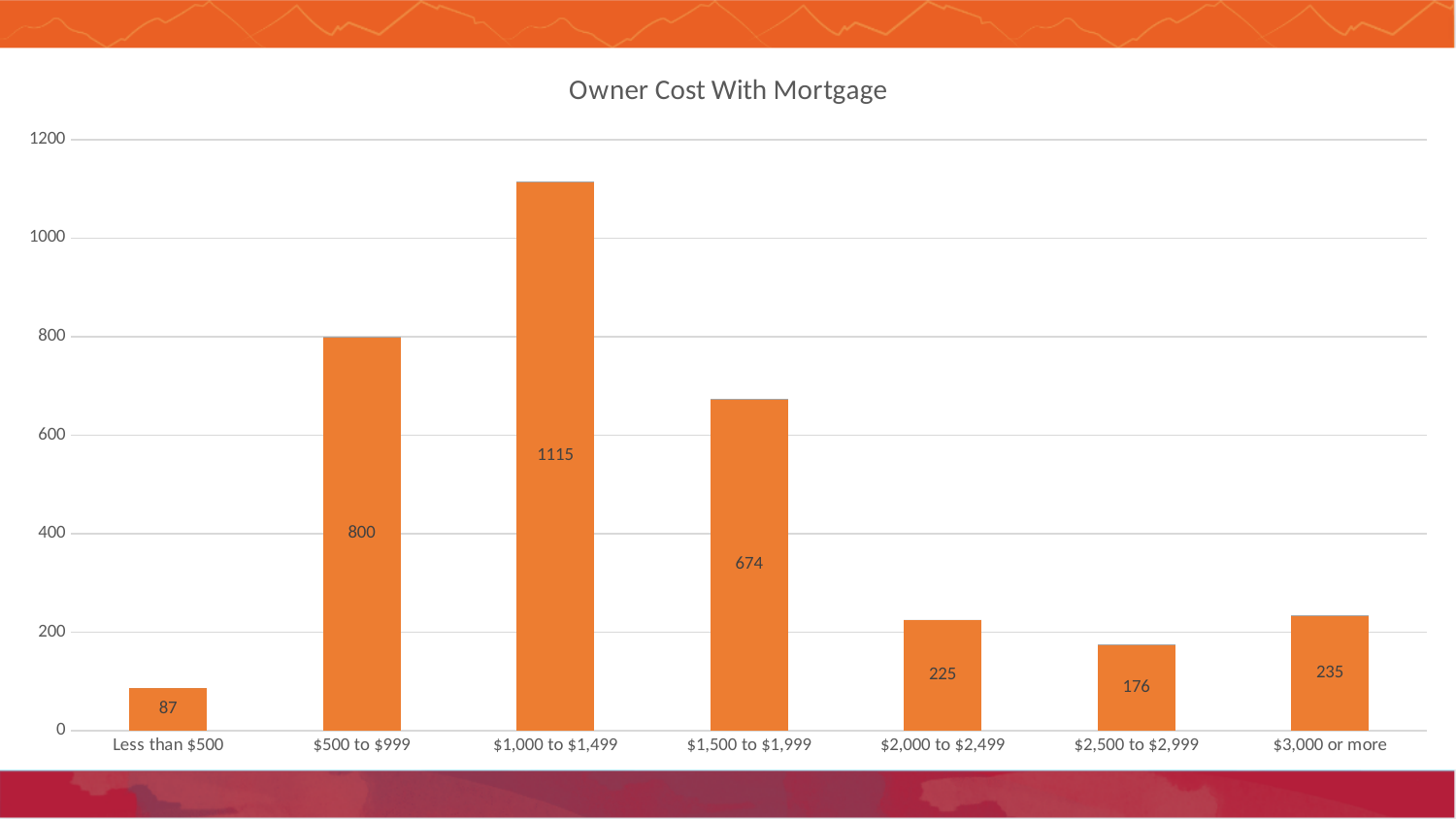
What is the difference between the values for $3,000 or more and $2,500 to $2,999? 59 Which is larger, the value for $2,000 to $2,499 or the value for $2,500 to $2,999? $2,000 to $2,499 Which category has the lowest value? Less than $500 Which category has the highest value? $1,000 to $1,499 What is the difference between the values for $500 to $999 and $1,500 to $1,999? 126 Is the value for $1,500 to $1,999 greater or less than 600? greater What kind of chart is shown on the slide? bar chart What is the value for the $3,000 or more category? 235 What is the title of the chart? Owner Cost With Mortgage What is the value for the Less than $500 category? 87 What is the value for the $1,000 to $1,499 category? 1115 How many categories are shown on the x axis? 7